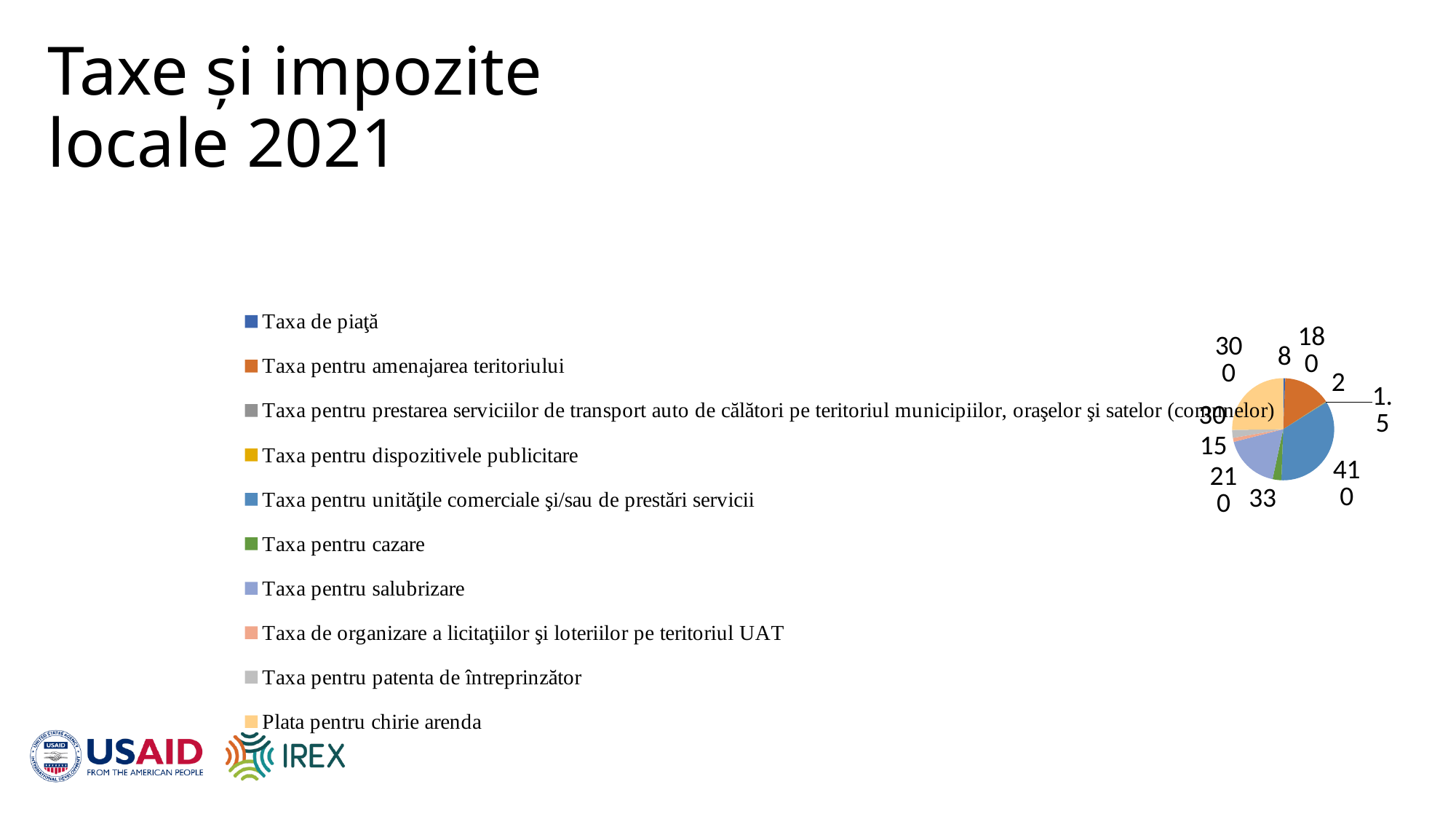
Which is larger: the slice for Taxa pentru salubrizare or the slice for Taxa pentru cazare? Taxa pentru salubrizare What is the difference between the values for Taxa pentru unitățile comerciale și/sau de prestări servicii and Plata pentru chirie arenda? 110 Which category has the largest slice in the pie chart? Taxa pentru unitățile comerciale și/sau de prestări servicii How many categories does the legend of the pie chart list? 10 What is the value shown for Taxa pentru amenajarea teritoriului? 180 What is the title of the slide containing the pie chart? Taxe și impozite locale 2021 What is the value shown for Taxa pentru unitățile comerciale și/sau de prestări servicii? 410 What kind of chart is shown on the slide? pie chart What colour is used for Taxa pentru cazare in the legend? green What is the value shown for Taxa pentru salubrizare? 210 What is the value shown for Plata pentru chirie arenda? 300 Which is larger: the slice for Taxa pentru unitățile comerciale și/sau de prestări servicii or the slice for Plata pentru chirie arenda? Taxa pentru unitățile comerciale și/sau de prestări servicii